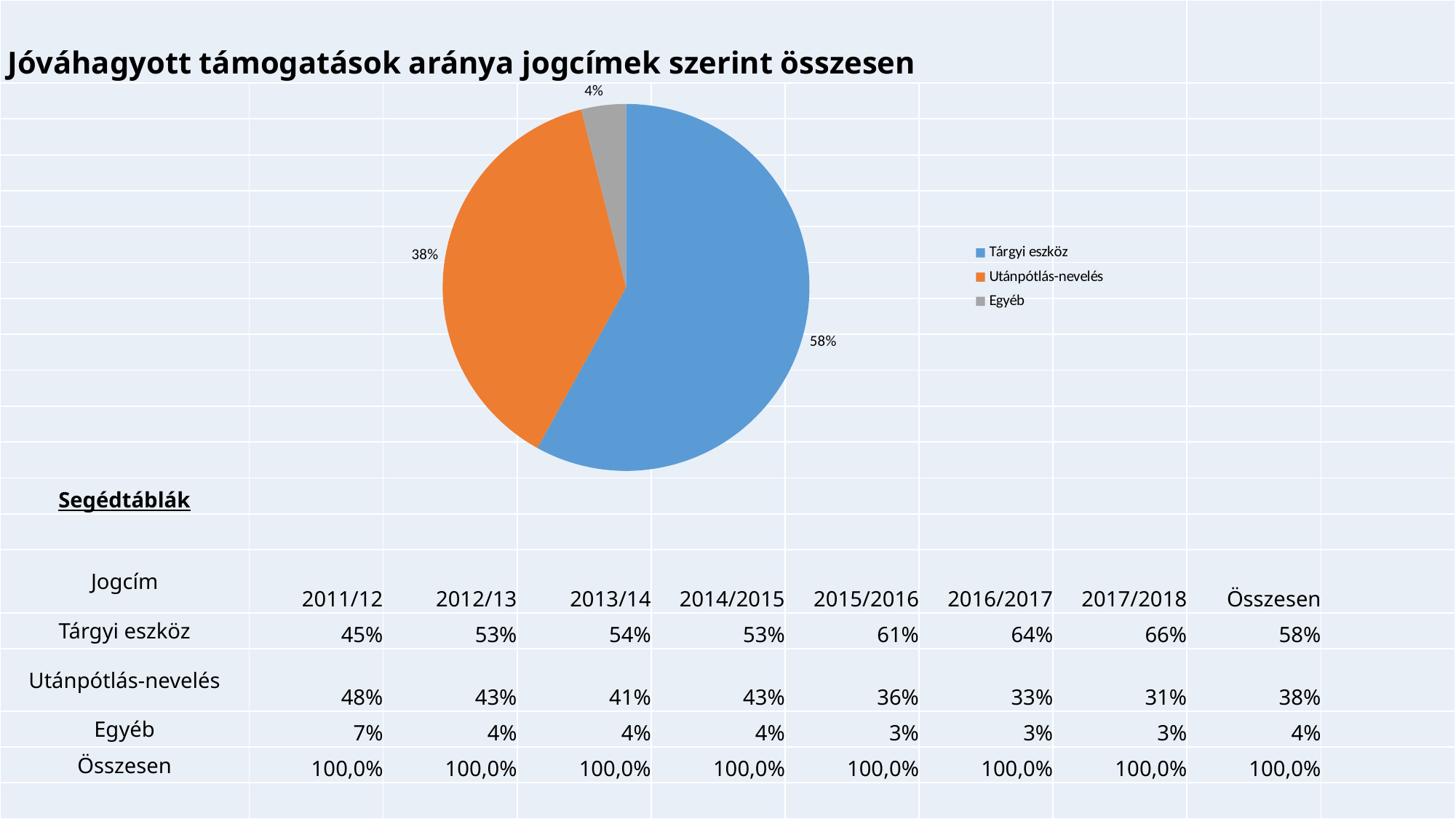
What is the title of the chart? Jóváhagyott támogatások aránya jogcímek szerint összesen What is the difference between the Tárgyi eszköz and Utánpótlás-nevelés shares? 20% Which is larger, the Utánpótlás-nevelés slice or the Egyéb slice? Utánpótlás-nevelés What share of the pie does Utánpótlás-nevelés have? 38% How many entries does the legend list? 3 What share of the pie does Tárgyi eszköz have? 58% Which category has the smallest slice of the pie? Egyéb Which category has the largest slice of the pie? Tárgyi eszköz What colour is the Utánpótlás-nevelés slice? orange How many slices does the pie chart have? 3 What type of chart is shown on the slide? pie chart What share of the pie does Egyéb have? 4%